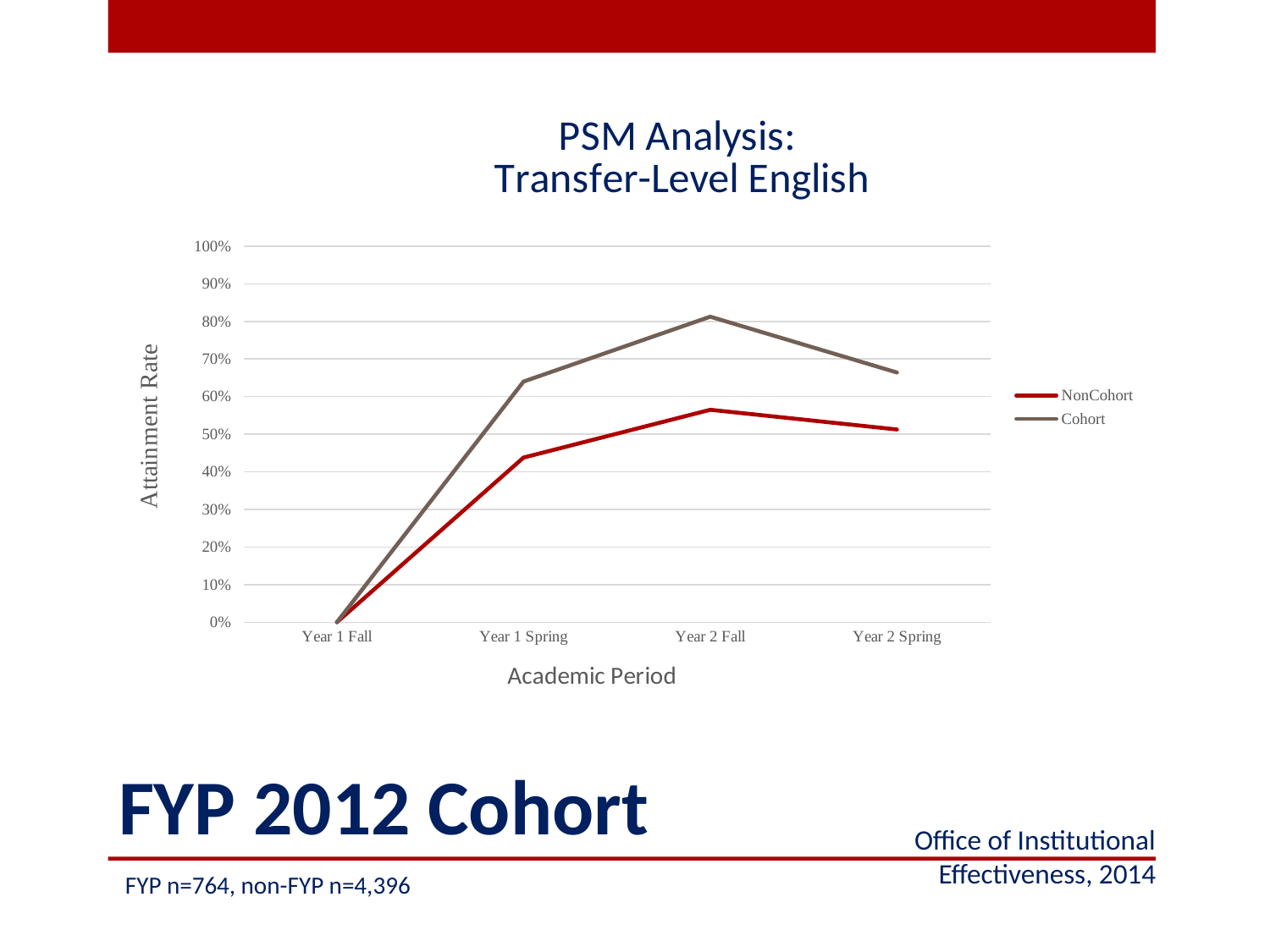
How many academic periods are plotted along the x axis? 4 At which academic period does the Cohort series reach its highest attainment rate? Year 2 Fall What is the attainment rate for the Cohort series at Year 1 Fall? 0% Is the Cohort attainment rate at Year 2 Fall greater or less than 80%? greater At which academic period does the NonCohort series reach its highest attainment rate? Year 2 Fall Is the NonCohort attainment rate at Year 1 Spring greater or less than 50%? less What is the attainment rate for the NonCohort series at Year 1 Fall? 0% What type of chart is shown on the slide? line chart Is the Cohort attainment rate at Year 2 Spring greater or less than 60%? greater What is the title of the chart? PSM Analysis: Transfer-Level English How many series does the legend list? 2 At Year 2 Spring, which series has the higher attainment rate, Cohort or NonCohort? Cohort